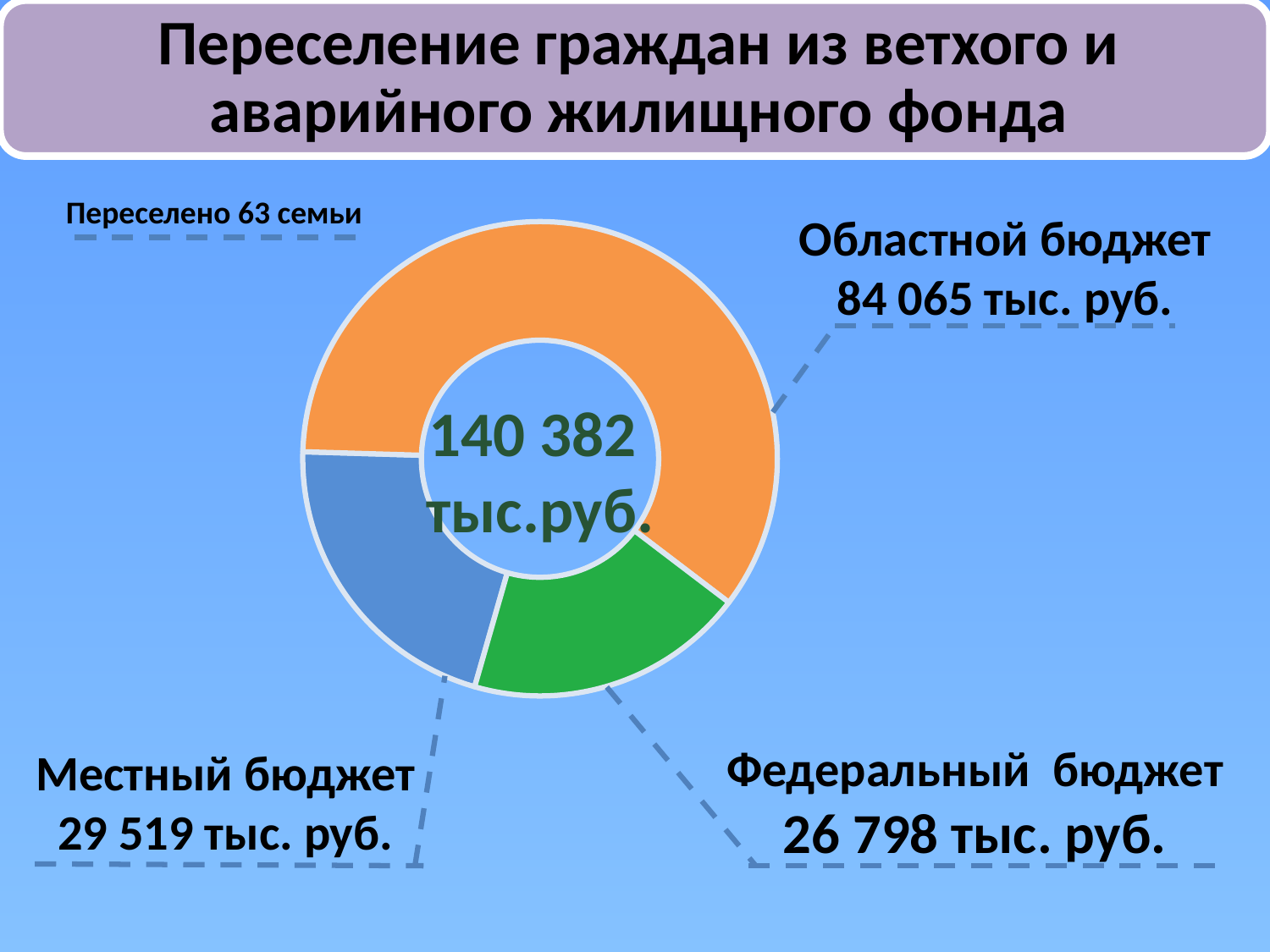
Which budget source has the smallest share of the chart? Федеральный бюджет What total is shown in the centre of the chart? 140 382 тыс.руб. How many segments does the chart have? 3 What colour is the segment for Областной бюджет? Orange What kind of chart is shown on the slide? Pie (donut) chart What is the difference between Местный бюджет and Федеральный бюджет? 2 721 тыс. руб. What is the value for Областной бюджет? 84 065 тыс. руб. Which budget source has the largest share of the chart? Областной бюджет What is the difference between Областной бюджет and Местный бюджет? 54 546 тыс. руб. What is the value for Федеральный бюджет? 26 798 тыс. руб. Which is larger, Местный бюджет or Федеральный бюджет? Местный бюджет What is the value for Местный бюджет? 29 519 тыс. руб.